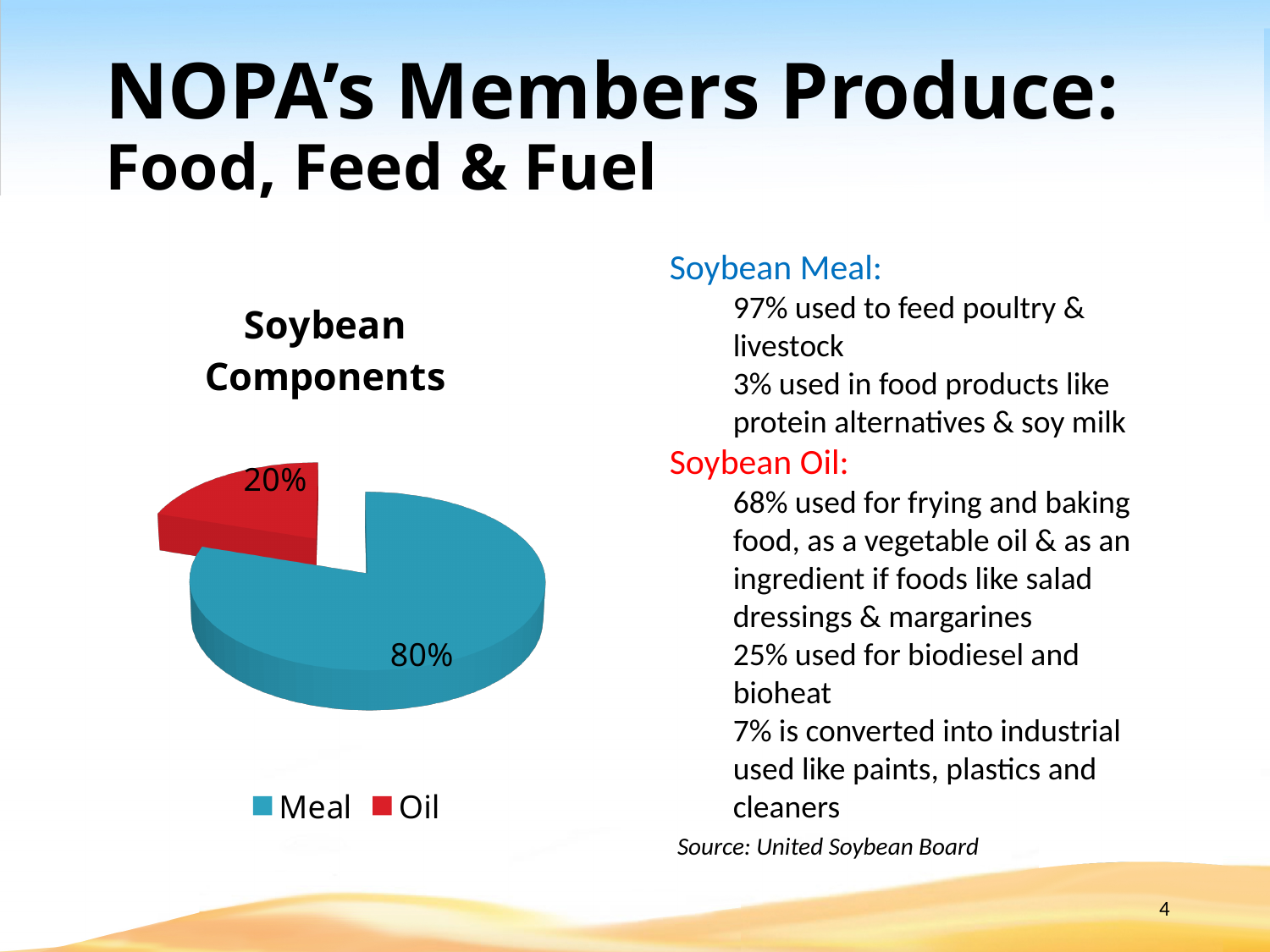
What is the title of the chart? Soybean Components How many slices does the pie chart have? 2 Which component has the smallest share of the pie? Oil How many entries does the legend list? 2 Which is larger, the share for Meal or the share for Oil? Meal What percentage of the pie does Oil represent? 20% What percentage of the pie does Meal represent? 80% Which component has the largest share of the pie? Meal What is the combined share of Meal and Oil in the pie chart? 100% What is the difference in percentage points between the Meal and Oil shares? 60 What colour is the Oil slice in the pie chart? Red What type of chart is shown on the slide? Pie chart